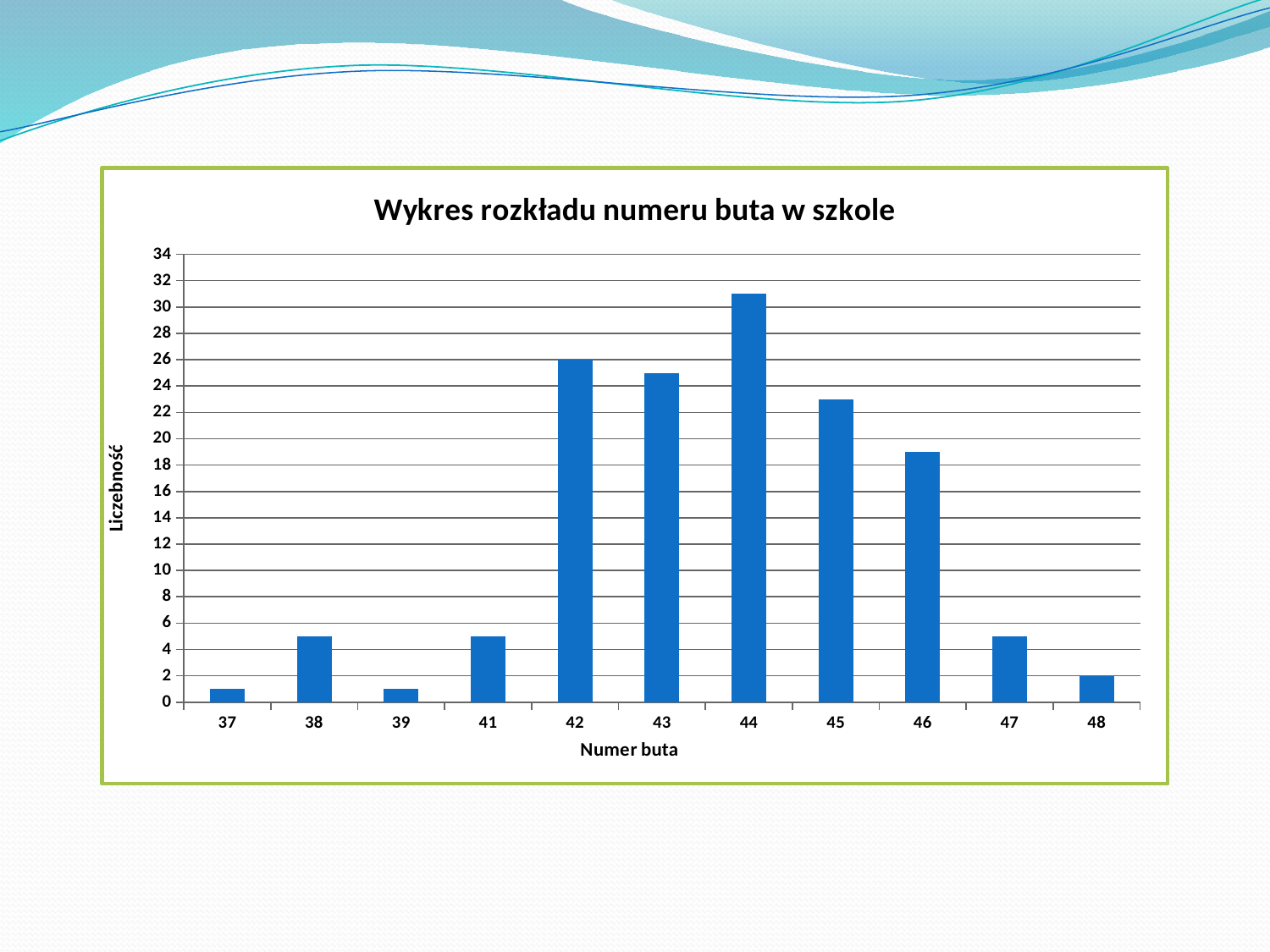
Is the value for shoe size 46 greater or less than 20? less What is the Liczebność for shoe size 48? 2 What is the Liczebność for shoe size 42? 26 Is the value for shoe size 45 greater or less than 22? greater Which has a larger Liczebność, shoe size 44 or shoe size 45? 44 What kind of chart is shown on the slide? bar chart Which shoe size (Numer buta) has the highest Liczebność? 44 What is the title of the chart? Wykres rozkładu numeru buta w szkole Which has a larger Liczebność, shoe size 38 or shoe size 46? 46 How many shoe size categories are shown on the x axis? 11 Is the value for shoe size 44 greater or less than 30? greater What is the label of the vertical axis? Liczebność